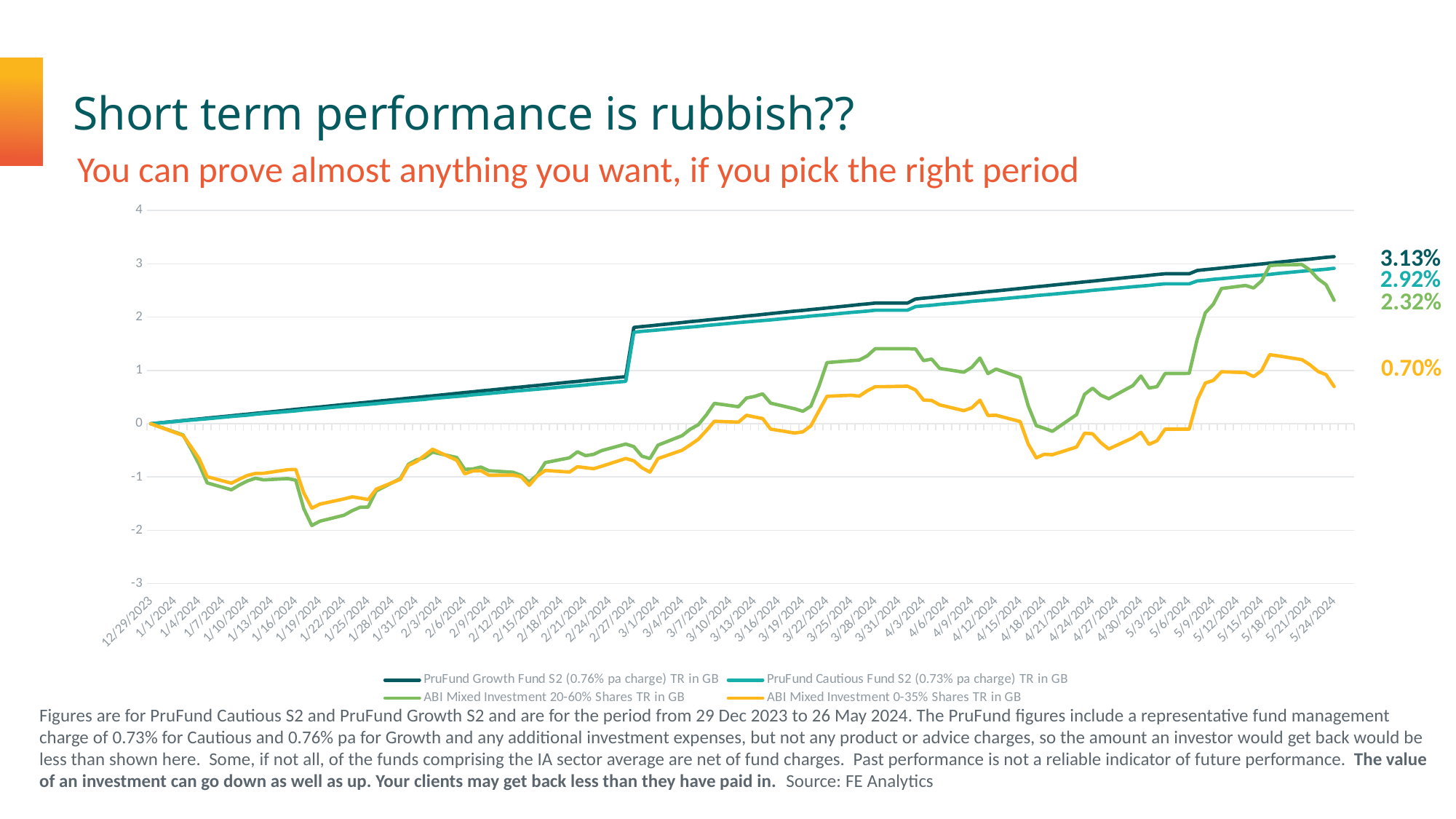
What is the difference between the final values of PruFund Growth Fund S2 and PruFund Cautious Fund S2? 0.21% How many series does the legend list? 4 What is the final value shown for PruFund Growth Fund S2 (0.76% pa charge) TR in GB? 3.13% Which has the larger final value: ABI Mixed Investment 20-60% Shares or ABI Mixed Investment 0-35% Shares? ABI Mixed Investment 20-60% Shares TR in GB What is the final value shown for ABI Mixed Investment 0-35% Shares TR in GB? 0.70% What kind of chart is shown on the slide? line chart What is the final value shown for PruFund Cautious Fund S2 (0.73% pa charge) TR in GB? 2.92% Does the PruFund Growth Fund S2 line rise or fall from left to right across the chart? rise Which series has the lowest final value? ABI Mixed Investment 0-35% Shares TR in GB Which series has the highest final value? PruFund Growth Fund S2 (0.76% pa charge) TR in GB Is the final value for ABI Mixed Investment 0-35% Shares TR in GB greater or less than 1? less What is the final value shown for ABI Mixed Investment 20-60% Shares TR in GB? 2.32%